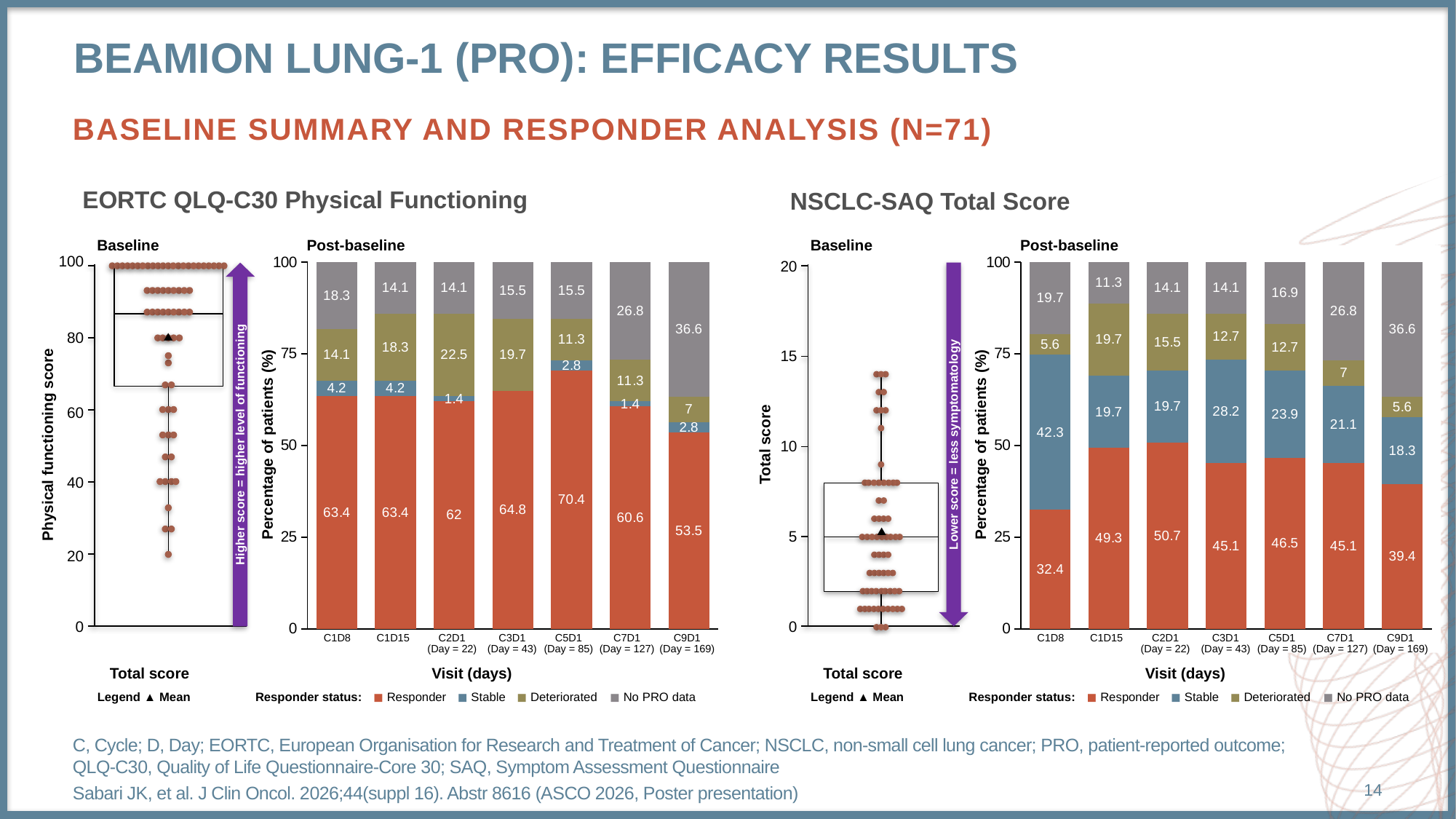
What is the y-axis label of the EORTC QLQ-C30 Physical Functioning baseline box plot? Physical functioning score In the NSCLC-SAQ Total Score post-baseline chart, which is larger: the responder percentage at C2D1 or at C3D1? C2D1 In the EORTC QLQ-C30 Physical Functioning post-baseline chart, at which visit is the responder percentage highest? C5D1 (Day = 85) What kind of chart is the EORTC QLQ-C30 Physical Functioning post-baseline chart? Stacked bar chart In the NSCLC-SAQ Total Score post-baseline chart, what is the difference between the stable percentage at C1D8 (42.3) and at C1D15 (19.7)? 22.6 In the NSCLC-SAQ Total Score post-baseline chart, what percentage of patients had no PRO data at C9D1 (Day = 169)? 36.6 In the EORTC QLQ-C30 Physical Functioning post-baseline chart, what is the difference between the responder percentage at C5D1 (70.4) and at C9D1 (53.5)? 16.9 In the NSCLC-SAQ Total Score post-baseline chart, what percentage of patients were stable at C1D8? 42.3 How many responder status categories does the legend of the NSCLC-SAQ Total Score post-baseline chart list? 4 In the NSCLC-SAQ Total Score post-baseline chart, at which visit is the responder percentage lowest? C1D8 In the EORTC QLQ-C30 Physical Functioning post-baseline chart, what percentage of patients were responders at C5D1 (Day = 85)? 70.4 How many visits are shown on the x axis of the EORTC QLQ-C30 Physical Functioning post-baseline chart? 7